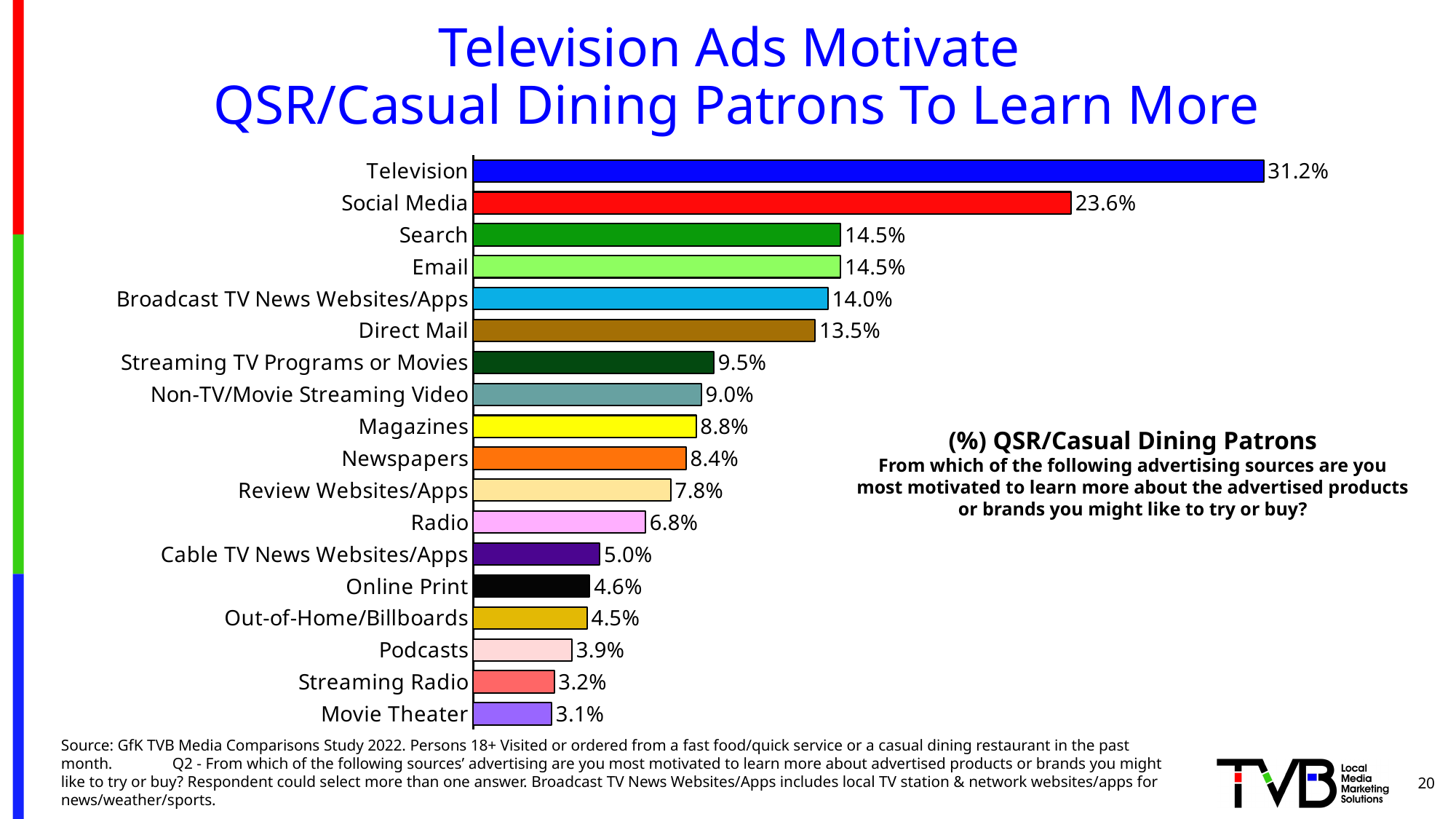
What type of chart is shown on the slide? Bar chart Which has a larger value, Magazines or Newspapers? Magazines What percentage of QSR/Casual Dining patrons are most motivated by Television ads to learn more? 31.2% Which advertising source has the highest value on the chart? Television What is the value shown for Direct Mail? 13.5% What is the difference between the values for Streaming TV Programs or Movies and Non-TV/Movie Streaming Video? 0.5% What is the value shown for Social Media? 23.6% What is the difference between the values for Television and Social Media? 7.6% How many advertising sources are shown on the chart? 18 Which advertising source has the lowest value on the chart? Movie Theater What is the value shown for Radio? 6.8% What colour is the bar for Television? Blue